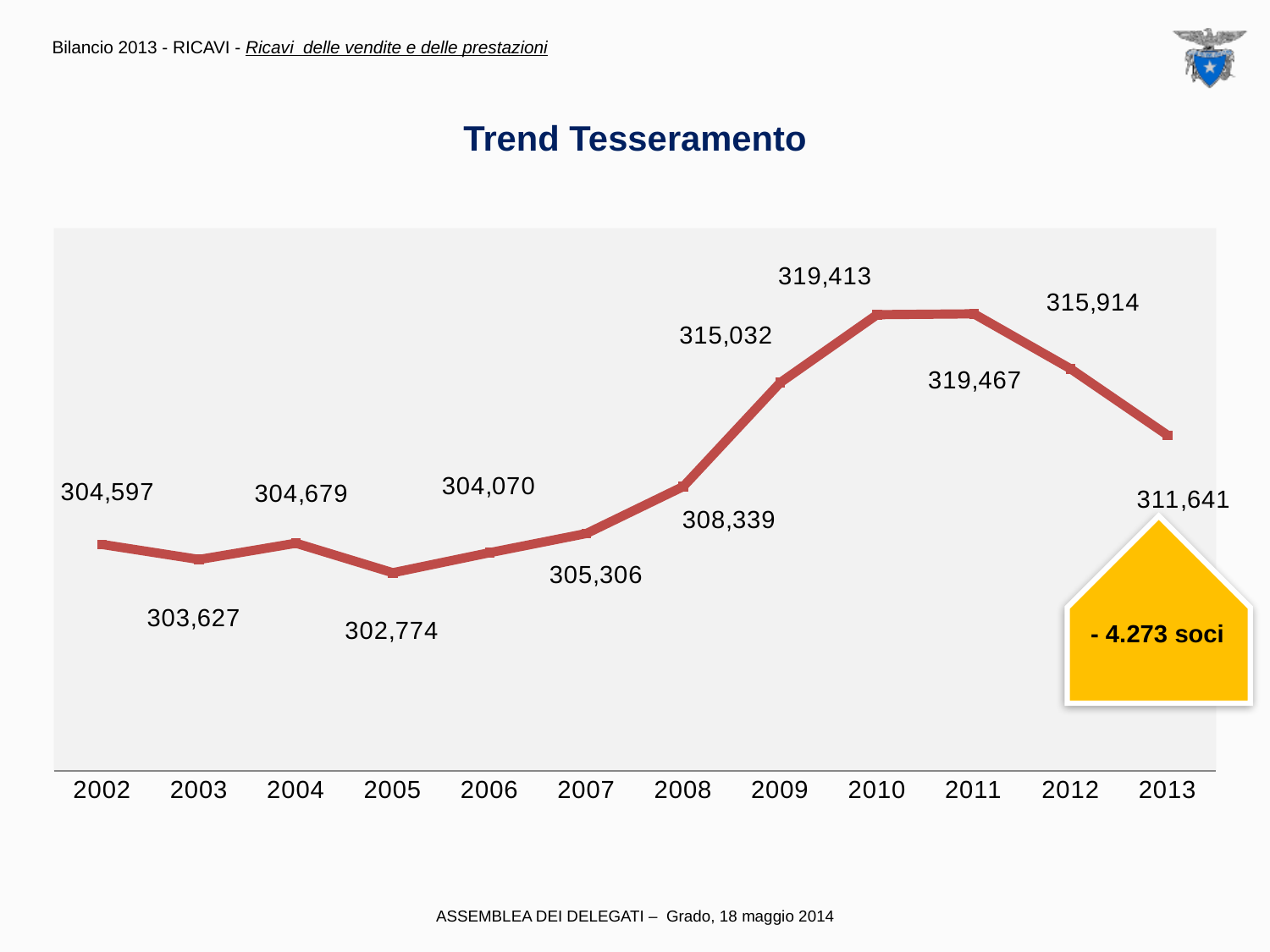
What is the difference between the values for 2008 and 2007? 3,033 How many years are plotted on the x axis? 12 Do the values rise or fall from 2011 to 2013? fall What is the value for 2013? 311,641 What is the title of the chart? Trend Tesseramento Which is larger, the value for 2012 or the value for 2009? 2012 Which year has the lowest value? 2005 What is the value for 2002? 304,597 What is the value for 2009? 315,032 What is the difference between the values for 2012 and 2013? 4,273 Do the values rise or fall from 2007 to 2010? rise What kind of chart is shown on the slide? line chart